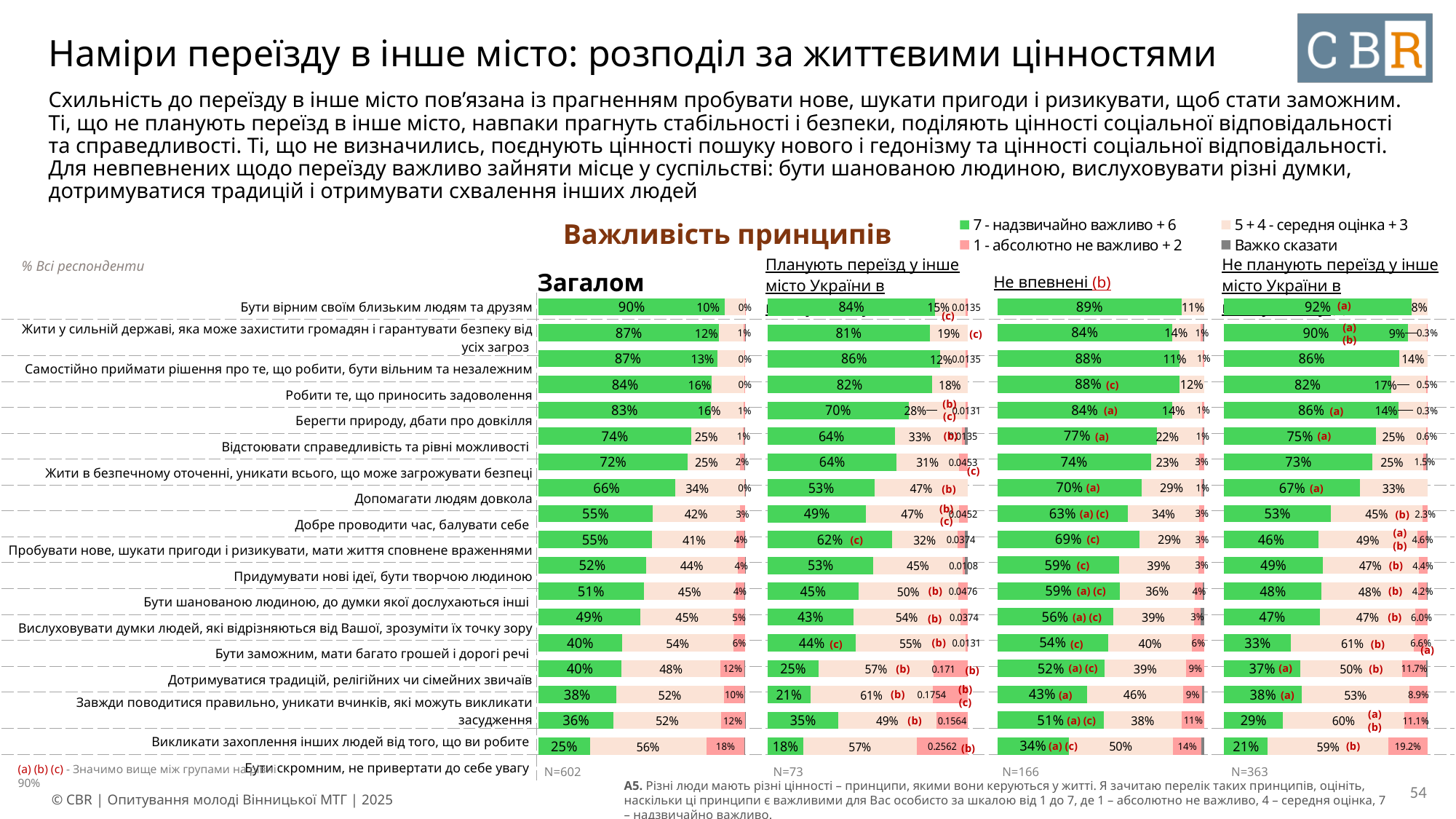
What kind of chart is used on this slide? Stacked bar chart On the "Загалом" chart, what is the value of the "7 - надзвичайно важливо + 6" series for "Бути вірним своїм близьким людям та друзям"? 90% What is the title shown above the charts? Важливість принципів On the "Не впевнені" chart, which has the larger "7 - надзвичайно важливо + 6" value: "Бути вірним своїм близьким людям та друзям" or "Допомагати людям довкола"? Бути вірним своїм близьким людям та друзям On the "Загалом" chart, what is the "1 - абсолютно не важливо + 2" value for "Бути скромним, не привертати до себе увагу"? 18% On the "Планують переїзд у інше місто України в" chart, what is the "7 - надзвичайно важливо + 6" value for "Берегти природу, дбати про довкілля"? 70% How many principles (categories) are plotted on the "Загалом" chart? 18 On the "Загалом" chart, which principle has the lowest "7 - надзвичайно важливо + 6" value? Бути скромним, не привертати до себе увагу On the "Не планують переїзд у інше місто України в" chart, what is the "7 - надзвичайно важливо + 6" value for "Бути вірним своїм близьким людям та друзям"? 92% How many series does the legend list? 4 On the "Загалом" chart, what is the difference between the "7 - надзвичайно важливо + 6" values for "Бути вірним своїм близьким людям та друзям" and "Бути скромним, не привертати до себе увагу"? 65 percentage points On the "Загалом" chart, which principle has the highest "7 - надзвичайно важливо + 6" value? Бути вірним своїм близьким людям та друзям